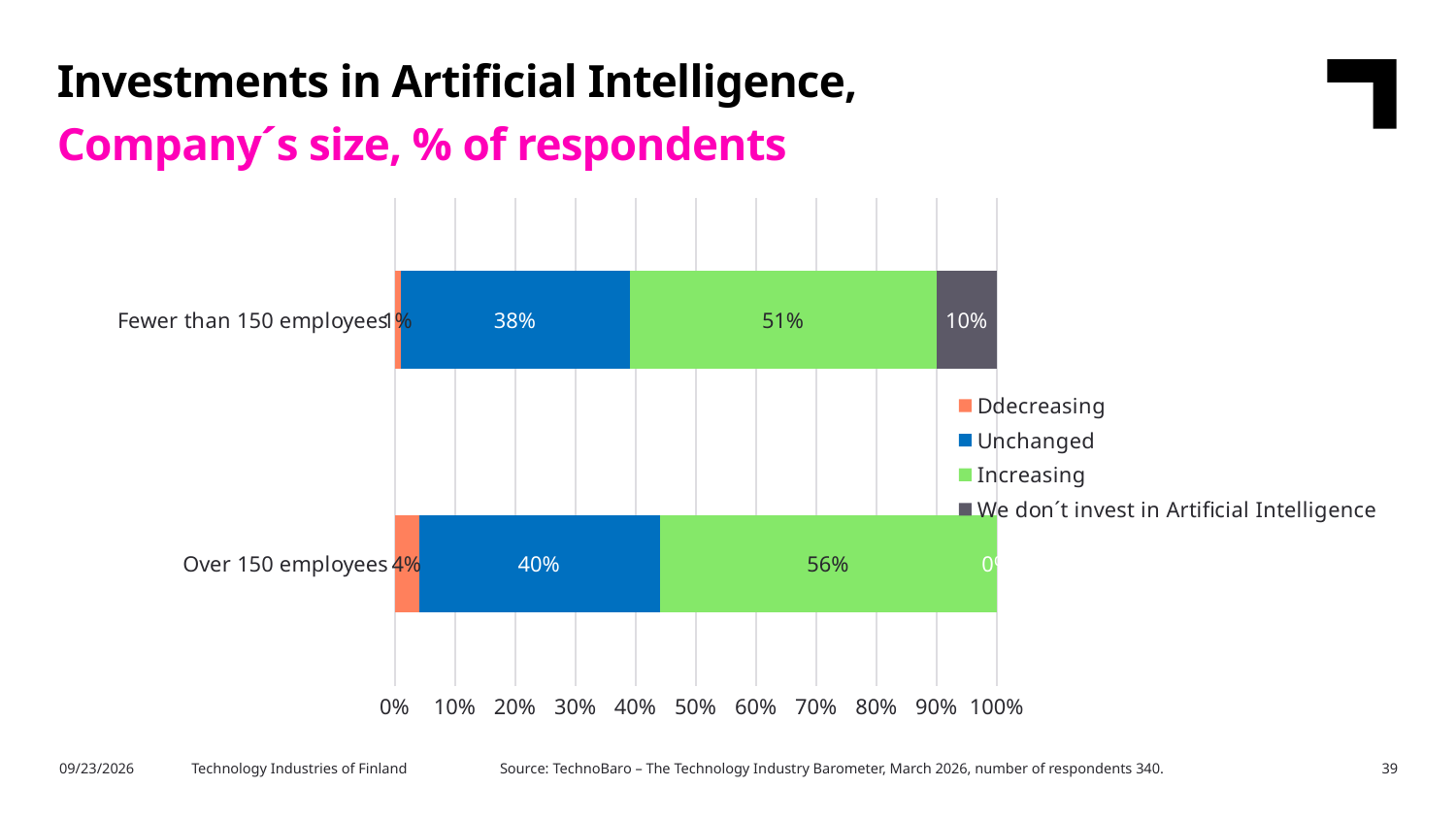
How many series does the legend list? 4 What is the difference between the Increasing values for Over 150 employees and Fewer than 150 employees? 5% Which series is shown in orange in the legend? Ddecreasing Which series has the largest share for Over 150 employees? Increasing What is the Ddecreasing value for Over 150 employees? 4% What kind of chart is shown on the slide? Stacked bar chart Which category has the higher Increasing value? Over 150 employees What is the Unchanged value for Fewer than 150 employees? 38% How many company-size categories are plotted? 2 What is the Unchanged value for Over 150 employees? 40% What is the 'We don´t invest in Artificial Intelligence' value for Fewer than 150 employees? 10% What is the Increasing value for Fewer than 150 employees? 51%